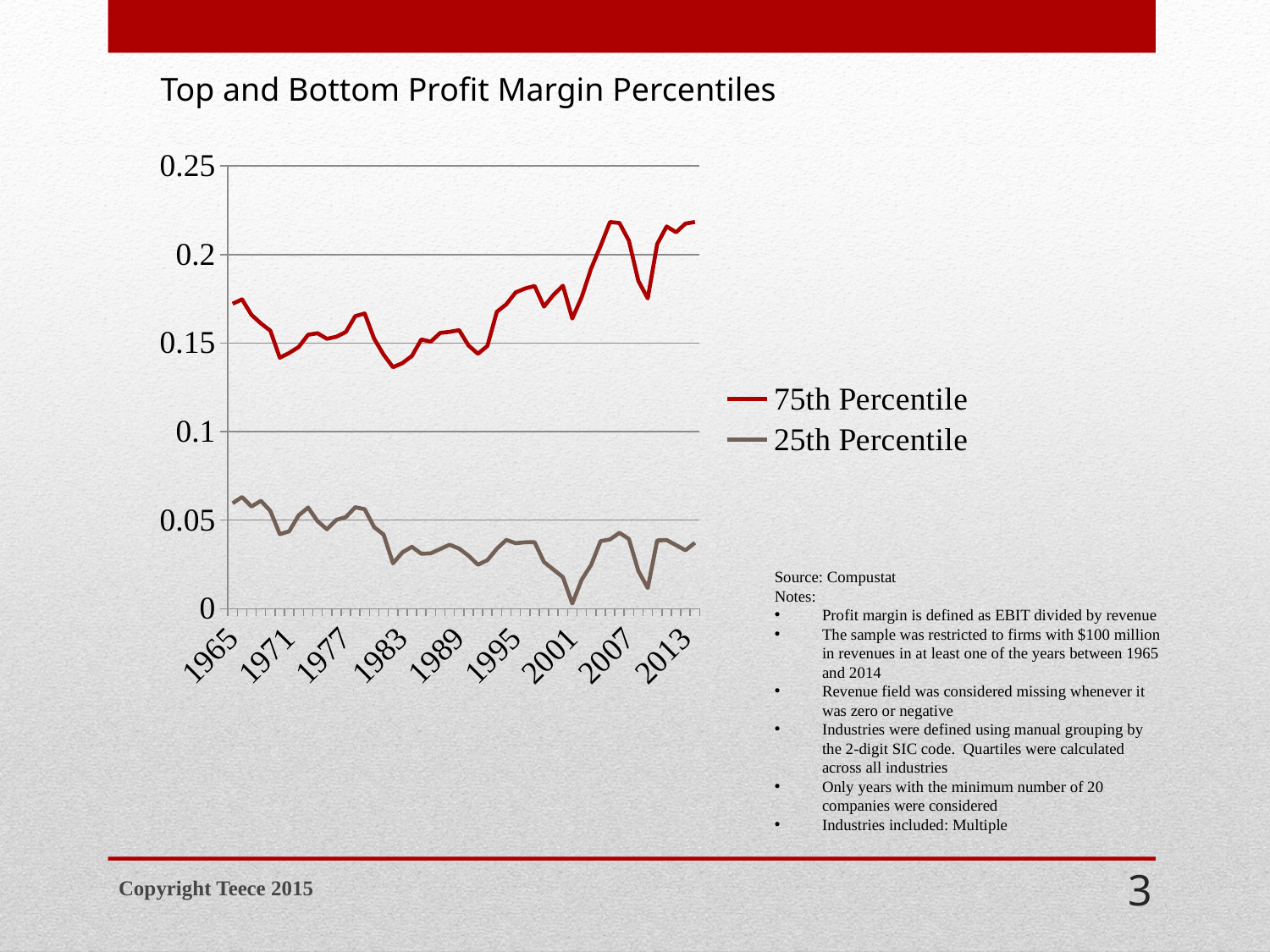
What is the title of the chart? Top and Bottom Profit Margin Percentiles Which series is plotted higher on the chart, the 75th Percentile or the 25th Percentile? 75th Percentile What are the two series named in the legend? 75th Percentile and 25th Percentile Is the value for the 75th Percentile in 1965 greater or less than 0.15? greater How many series does the legend list? 2 Is the value for the 75th Percentile in 1983 greater or less than 0.15? less Overall, does the 25th Percentile line rise or fall from 1965 to 2013? fall Overall, does the 75th Percentile line rise or fall from 1965 to 2013? rise Is the value for the 75th Percentile in 2007 greater or less than 0.2? greater What kind of chart is shown on the slide? Line chart